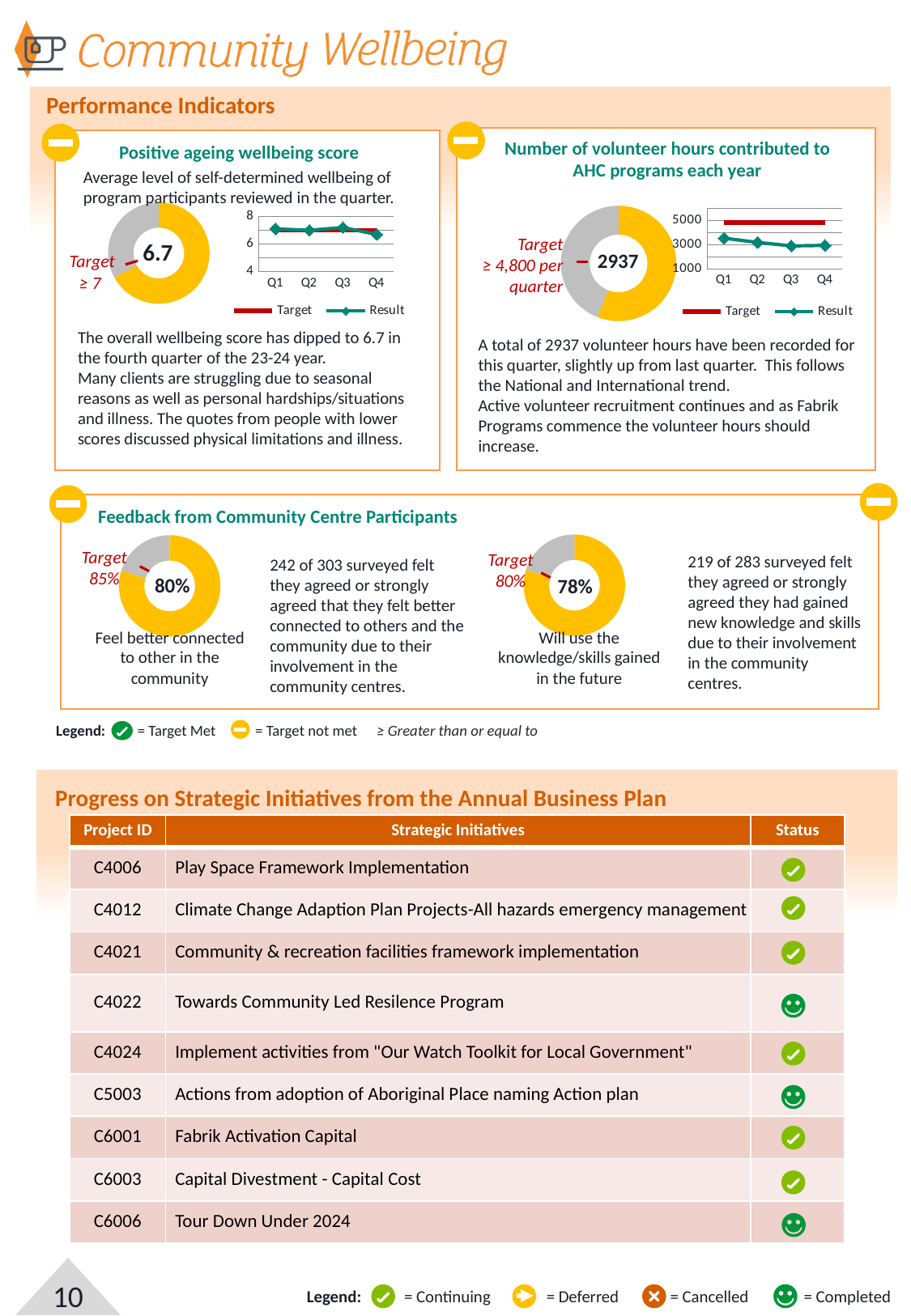
How many series does the legend of the line chart in the Positive ageing wellbeing score panel list? 2 What target is stated next to the Number of volunteer hours donut chart? ≥ 4,800 per quarter In the Feedback from Community Centre Participants section, what percentage is shown in the donut chart for 'Feel better connected to other in the community'? 80% In the line chart of the Number of volunteer hours panel, does the Result series rise or fall from Q1 to Q3? fall In the Number of volunteer hours contributed to AHC programs each year donut chart, what value is shown in the centre? 2937 In the Positive ageing wellbeing score donut chart, what value is shown in the centre? 6.7 In the line chart of the Number of volunteer hours panel, is the Result value for Q1 greater or less than 4000? less In the Feedback from Community Centre Participants section, which donut chart shows the larger percentage: 'Feel better connected to other in the community' or 'Will use the knowledge/skills gained in the future'? Feel better connected to other in the community How many quarters are plotted on the x axis of the line chart in the Number of volunteer hours panel? 4 In the Feedback from Community Centre Participants section, what is the difference between the 80% and 78% donut chart values? 2 percentage points In the Feedback from Community Centre Participants section, what percentage is shown in the donut chart for 'Will use the knowledge/skills gained in the future'? 78% What kind of chart is the Q1–Q4 chart in the Number of volunteer hours panel? Line chart